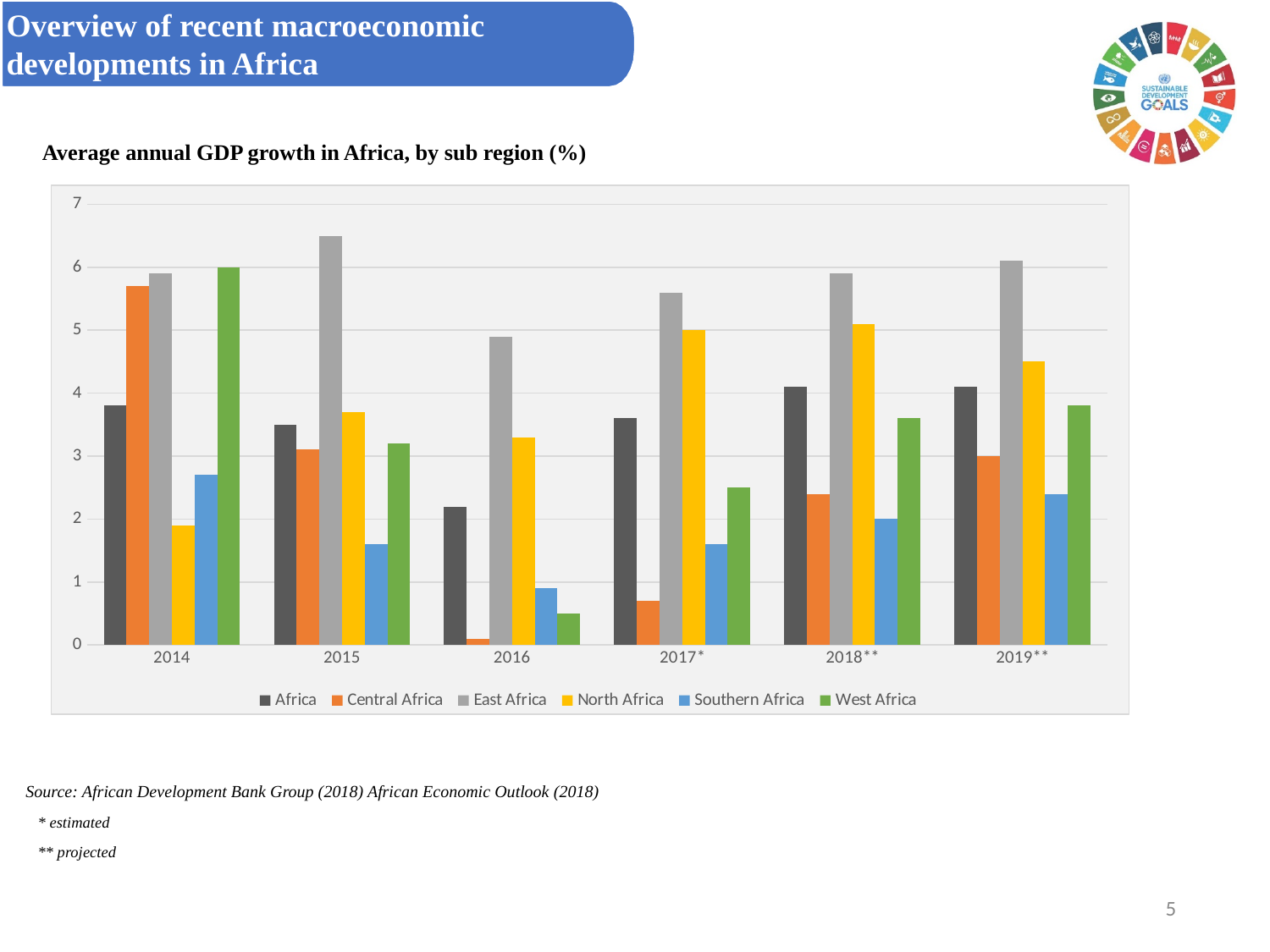
How many year categories are shown on the x axis? 6 Is the value for Central Africa in 2016 greater or less than 1? less Which series has the highest value in 2016? East Africa What kind of chart is shown on the slide? bar chart Does the value for Central Africa rise or fall from 2014 to 2016? fall Which is larger in 2014, Central Africa or Southern Africa? Central Africa Which series has the lowest value in 2016? Central Africa Is the value for East Africa in 2015 greater or less than 6? greater Which series has the lowest value in 2017*? Central Africa How many series does the legend list? 6 What is the title of the chart? Average annual GDP growth in Africa, by sub region (%) Is the value for West Africa in 2017* greater or less than 3? less